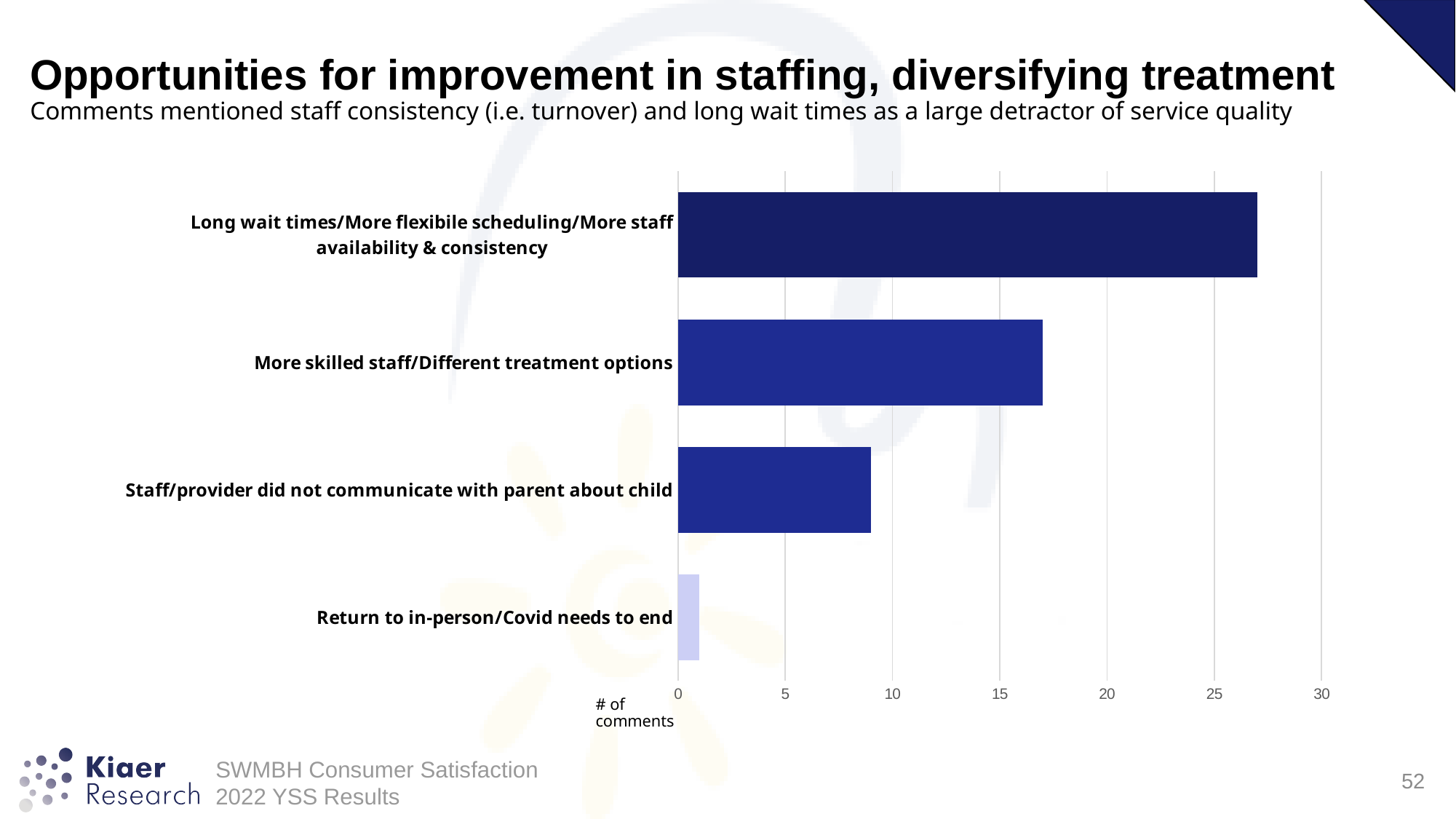
What kind of chart is shown on the slide? bar chart Is the value for Staff/provider did not communicate with parent about child greater or less than 10? less Which has more comments: More skilled staff/Different treatment options or Staff/provider did not communicate with parent about child? More skilled staff/Different treatment options Is the value for More skilled staff/Different treatment options greater or less than 15? greater Is the value for Long wait times/More flexibile scheduling/More staff availability & consistency greater or less than 25? greater What is the maximum value shown on the horizontal axis? 30 Which category has the highest number of comments? Long wait times/More flexibile scheduling/More staff availability & consistency How many categories are plotted in the chart? 4 What is the label on the horizontal axis of the chart? # of comments Which category has the lowest number of comments? Return to in-person/Covid needs to end